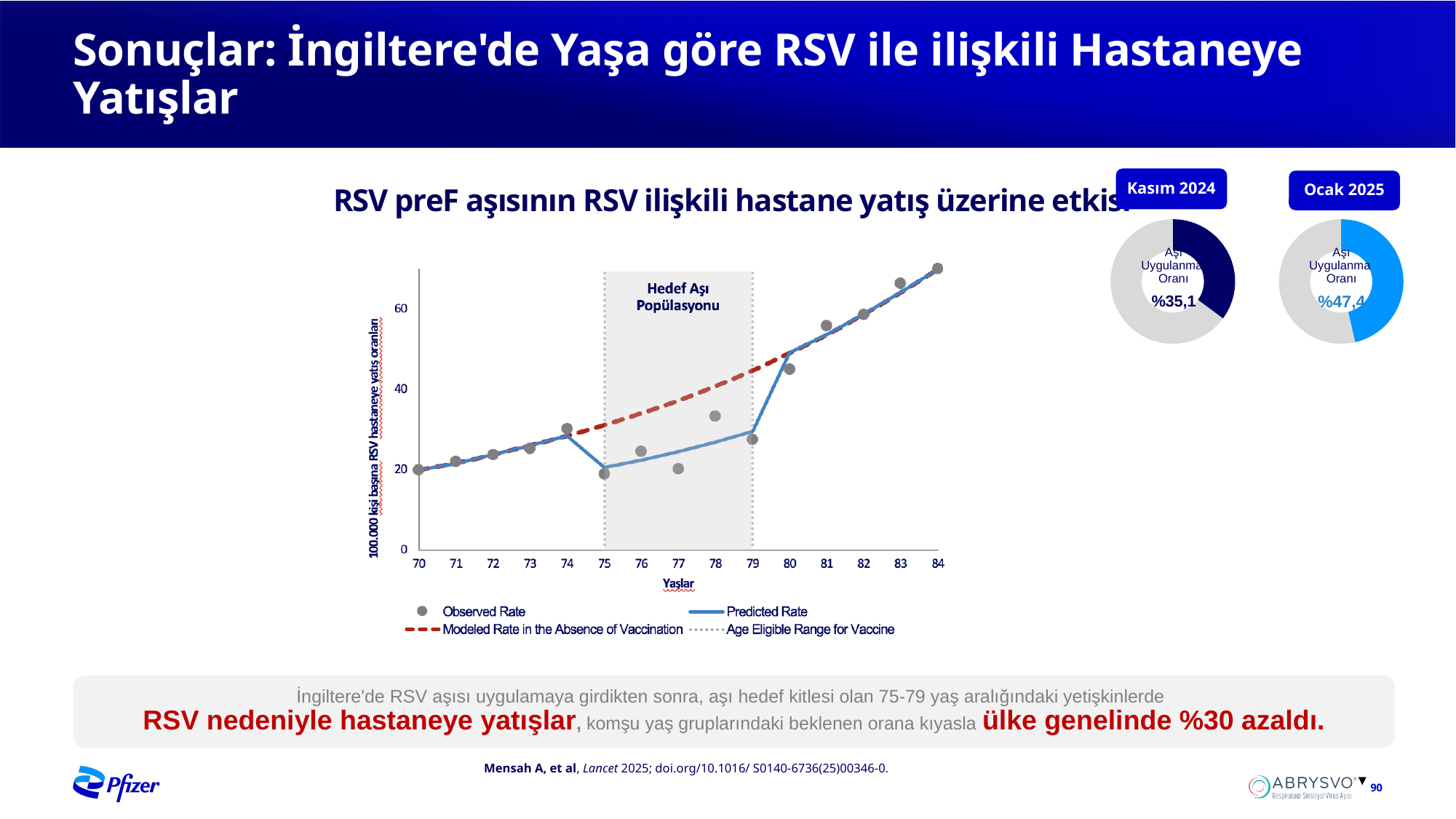
What kind of chart is the main chart showing RSV hospitalisation rates by age? line chart In the main chart, do the observed rates rise or fall from age 79 to age 84? rise How many entries does the legend of the main age chart list? 4 By how many percentage points does the vaccination rate in the Ocak 2025 donut exceed the one in the Kasım 2024 donut? 12,3 In the main chart, what label is written inside the shaded region between ages 75 and 79? Hedef Aşı Popülasyonu How many age values are marked on the x axis of the main chart? 15 In the Kasım 2024 donut chart, what is the vaccination rate (Aşı Uygulanma Oranı) shown? %35,1 In the main chart, is the observed rate for age 84 greater or less than 60? greater In the main chart, at which age is the observed rate highest? 84 In the main chart, is the observed rate for age 80 greater or less than 40? greater Comparing the two donut charts, which month shows the higher vaccination rate, Kasım 2024 or Ocak 2025? Ocak 2025 In the Ocak 2025 donut chart, what is the vaccination rate (Aşı Uygulanma Oranı) shown? %47,4